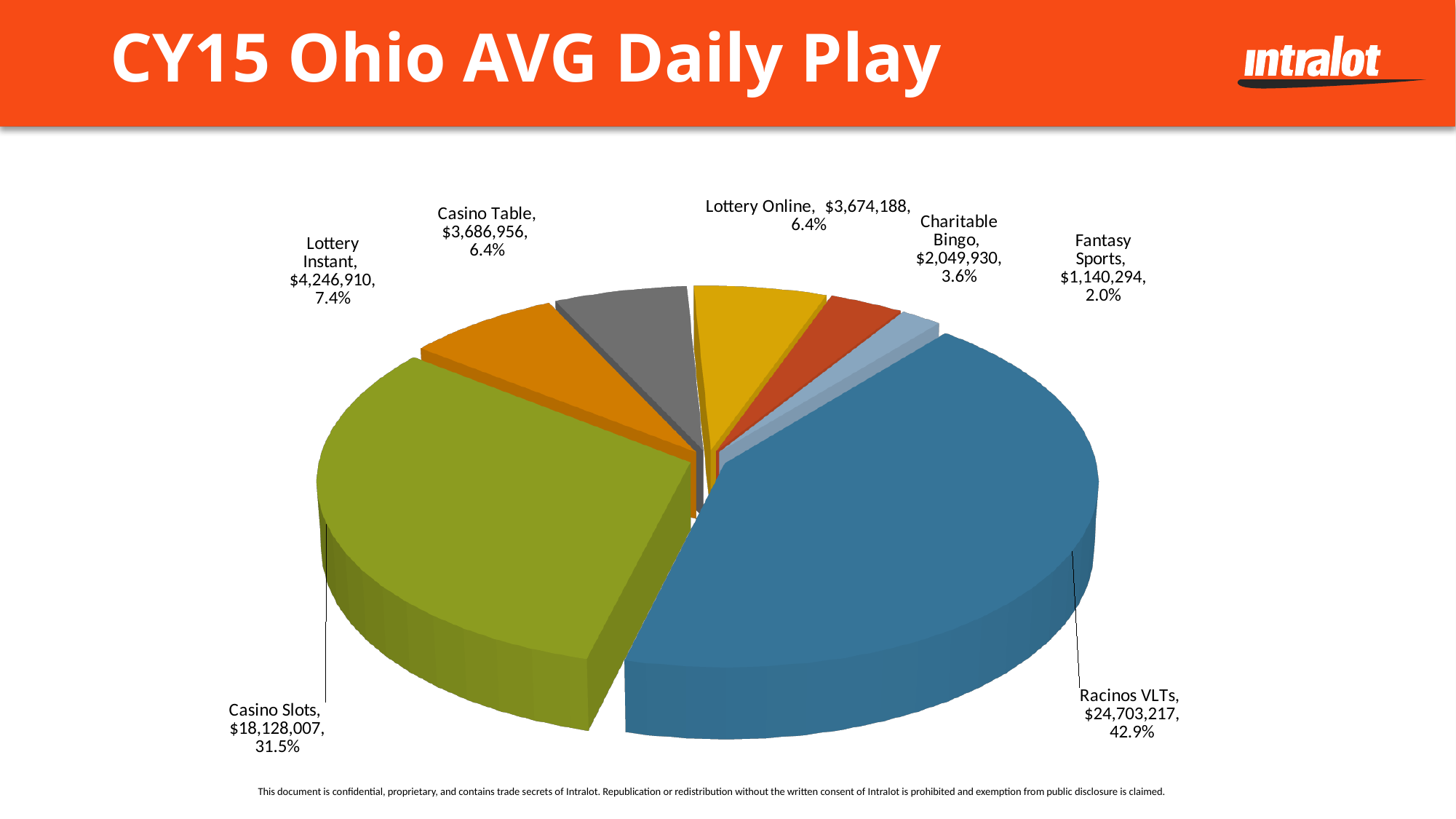
What type of chart is shown on the slide? Pie chart Which category has the largest slice of the pie? Racinos VLTs What is the title of the slide's chart? CY15 Ohio AVG Daily Play What is the difference between the values for Racinos VLTs and Casino Slots? $6,575,210 What share of the pie does Fantasy Sports represent? 2.0% What is the value for Charitable Bingo? $2,049,930 What is the value for Racinos VLTs? $24,703,217 What share of the pie does Lottery Instant represent? 7.4% Which is larger, the value for Lottery Instant or the value for Casino Table? Lottery Instant What is the value for Casino Slots? $18,128,007 How many slices does the pie chart have? 7 Which category has the smallest slice of the pie? Fantasy Sports